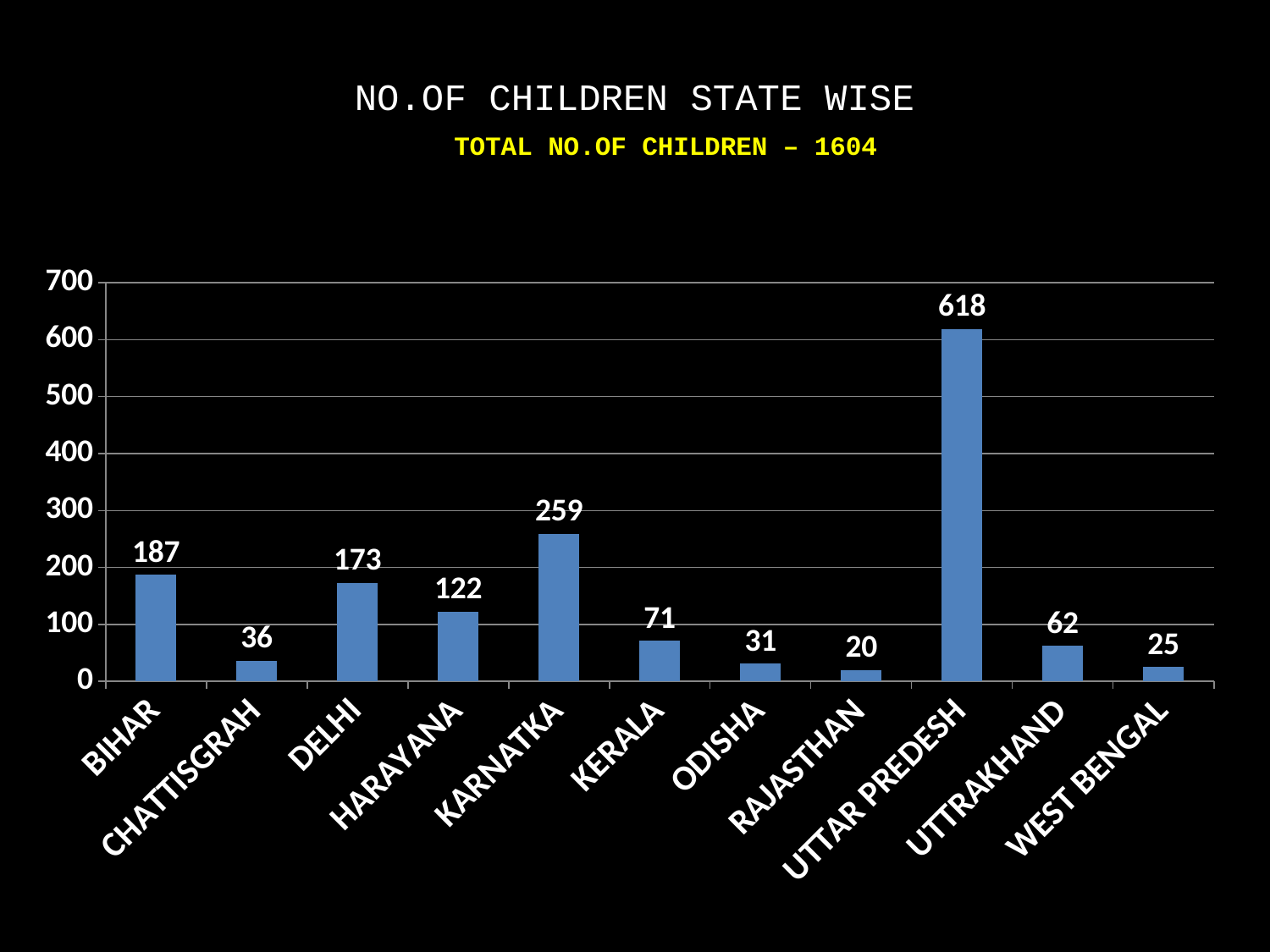
What is the number of children for Uttrakhand? 62 What kind of chart is shown on the slide? bar chart What is the number of children for Karnatka? 259 Is the value for Odisha greater or less than 100? less How many states are shown on the chart? 11 Which has more children, Harayana or Kerala? Harayana Which state has the lowest number of children? Rajasthan What is the difference between the number of children for Bihar and Delhi? 14 What is the difference between the number of children for Uttar Predesh and Karnatka? 359 Which state has the highest number of children? Uttar Predesh What is the number of children for Rajasthan? 20 What total number of children is stated in the subtitle of the chart? 1604